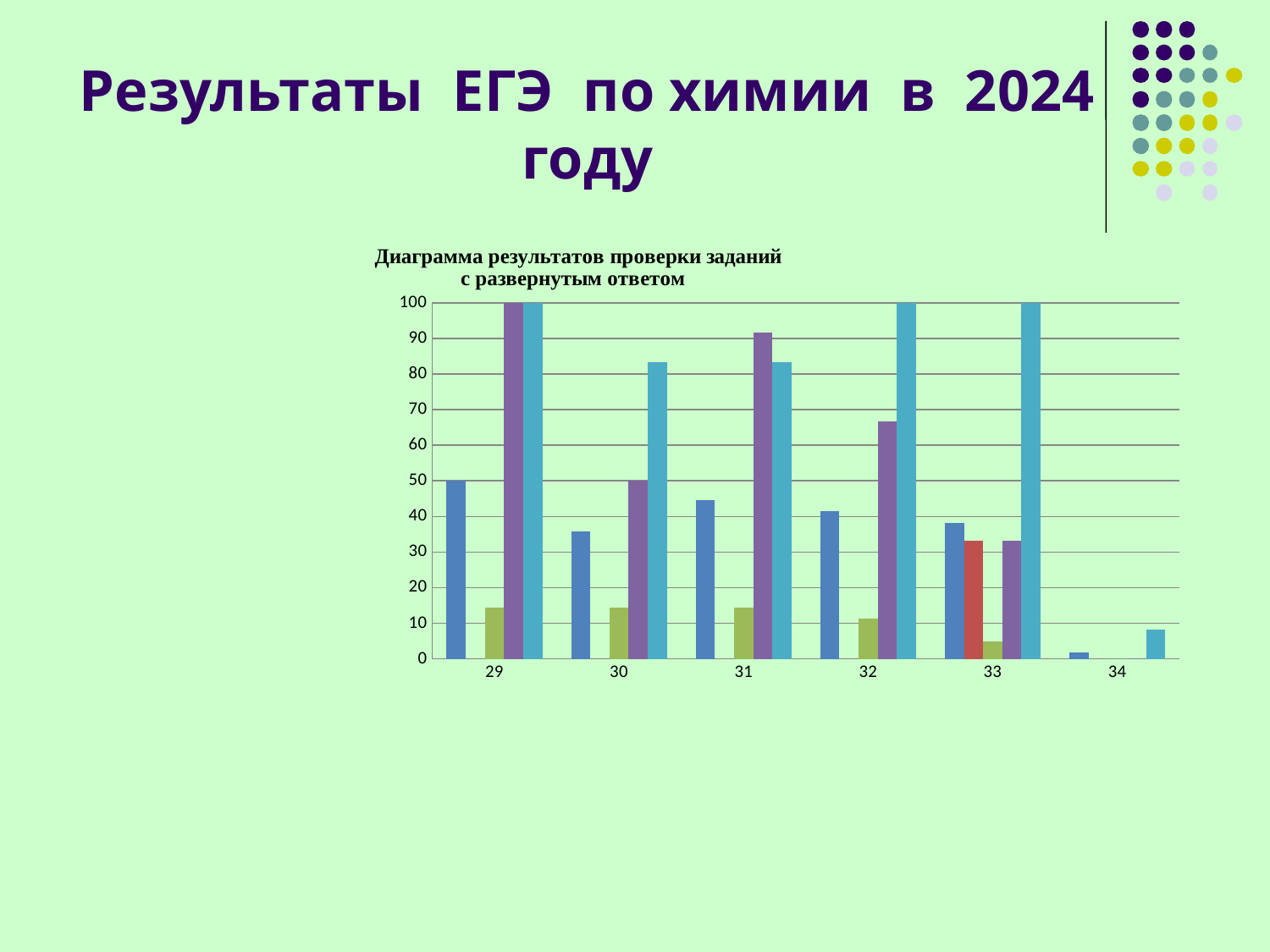
Is the value of the dark blue bar for category 34 greater or less than 10? less Which category has the lowest light blue bar? 34 What is the value of the dark blue bar for category 29? 50 For category 32, which is larger: the purple bar or the light blue bar? the light blue bar What is the value of the purple bar for category 30? 50 How many categories are shown on the x axis of the chart? 6 What is the title of the chart? Диаграмма результатов проверки заданий с развернутым ответом Is the value of the light blue bar for category 30 greater or less than 80? greater What kind of chart is shown on the slide? bar chart What is the value of the light blue bar for category 32? 100 Which category has the tallest dark blue bar? 29 What is the difference between the purple bar for category 29 and the purple bar for category 30? 50